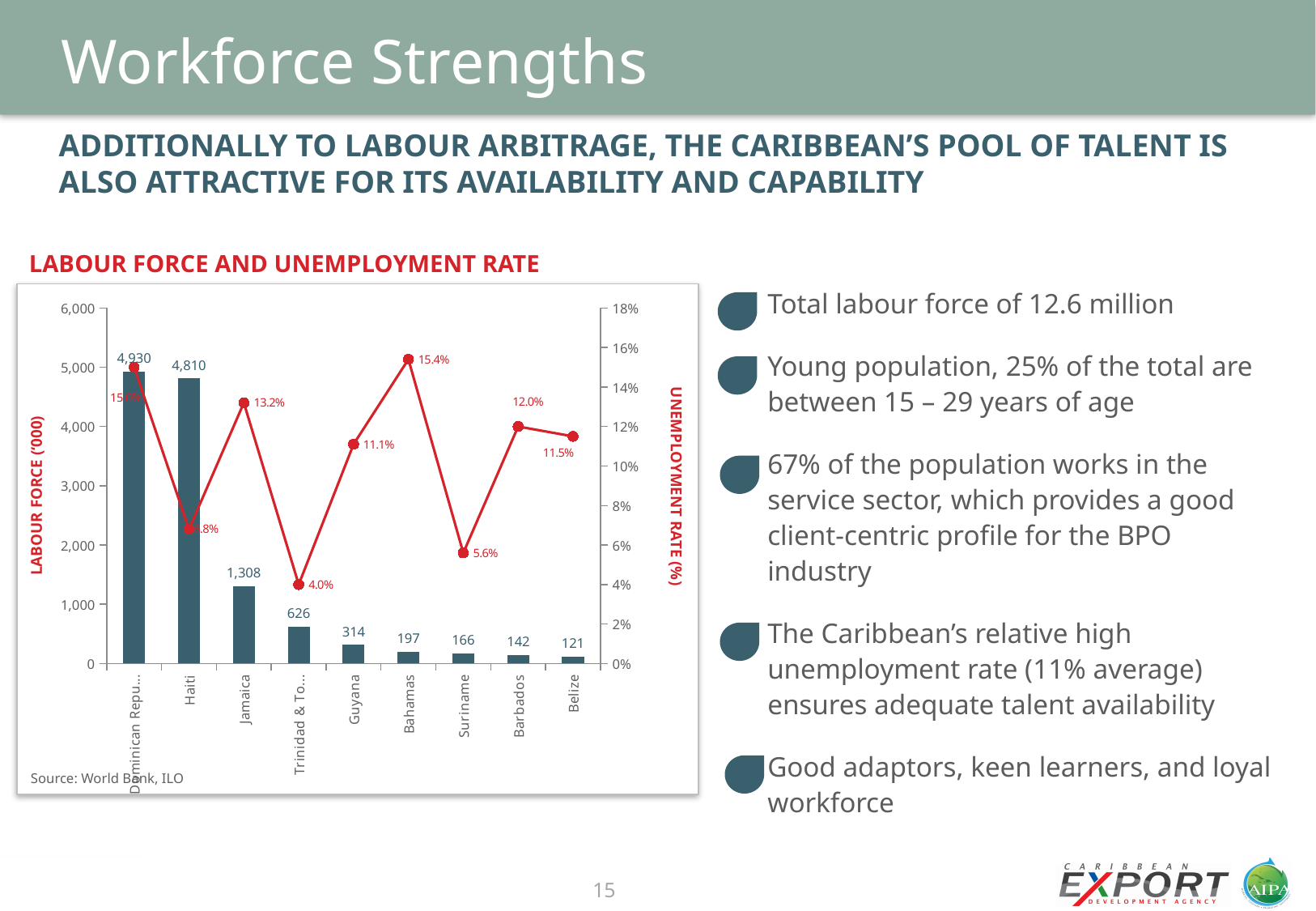
Which country has the lowest unemployment rate on the line? Trinidad & Tobago What is the labour force value shown for Haiti? 4,810 Is the unemployment rate for Barbados greater or less than 10%? greater Which country has the lowest labour force bar? Belize How many countries are shown on the x axis of the chart? 9 What unemployment rate is shown for the Bahamas? 15.4% Which has the larger labour force, Guyana or Bahamas? Guyana What is the difference in labour force between Haiti and Jamaica? 3,502 What unemployment rate is shown for Suriname? 5.6% What is the title of the chart? LABOUR FORCE AND UNEMPLOYMENT RATE Which country has the highest unemployment rate on the line? Bahamas What is the labour force value shown for Jamaica? 1,308